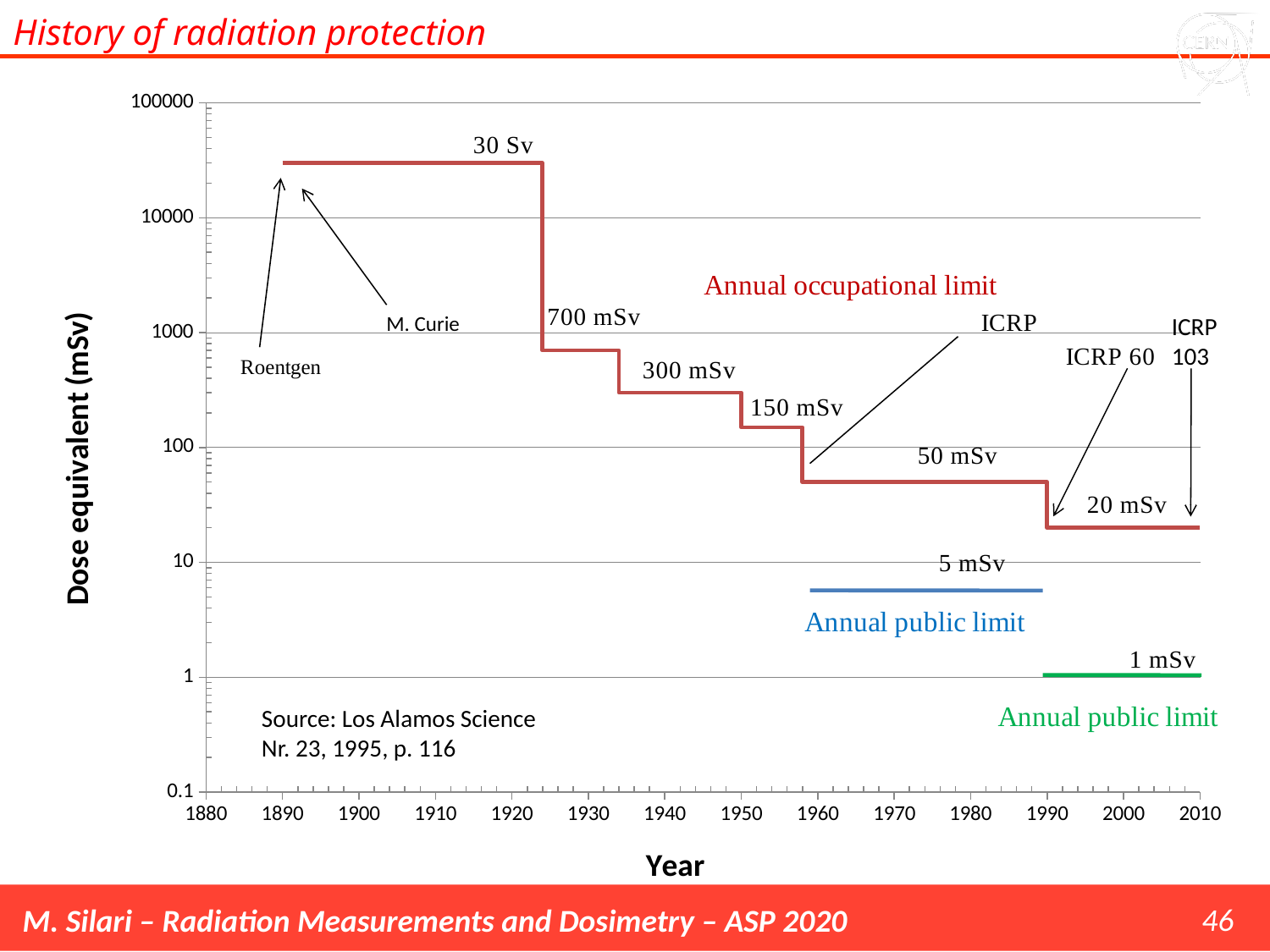
Is the annual occupational limit in 1940 greater or less than 100 mSv? greater Which is larger, the annual occupational limit labelled 300 mSv or the one labelled 150 mSv? 300 mSv What is the difference between the occupational limits labelled 700 mSv and 300 mSv? 400 mSv What is the label of the x axis? Year What is the label of the y axis? Dose equivalent (mSv) What is the lowest annual occupational limit value labelled on the chart? 20 mSv What is the annual public limit labelled on the green line? 1 mSv What is the annual occupational limit shown for the period after 1990, according to the data label? 20 mSv What is the highest annual occupational limit value labelled on the chart? 30 Sv What is the annual occupational limit shown for the period around 1970, according to the data label? 50 mSv What is the annual public limit labelled on the blue line? 5 mSv Does the annual occupational limit rise or fall over the years shown on the x axis? fall